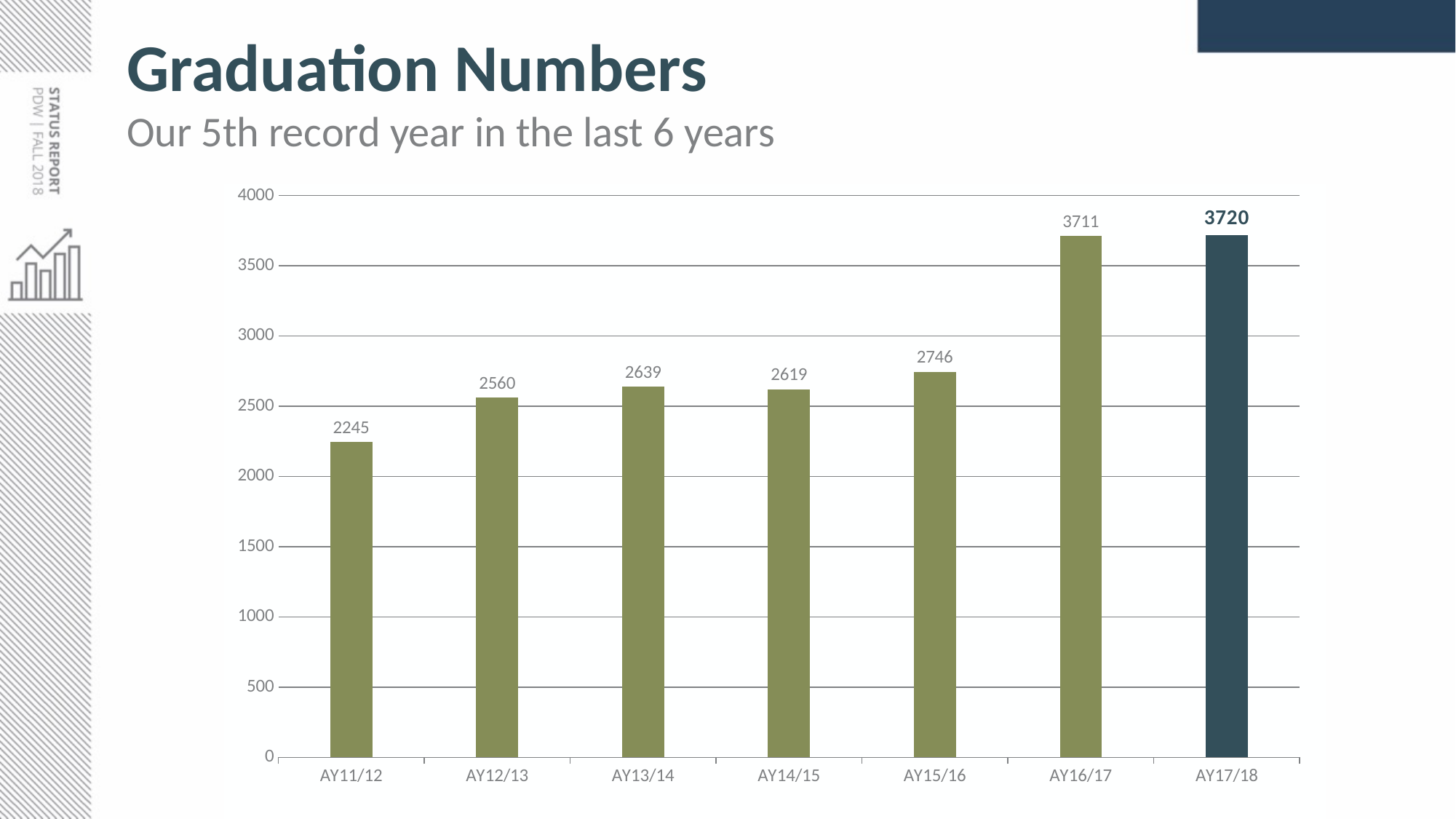
What is the graduation number for AY15/16? 2746 What is the graduation number for AY17/18? 3720 What kind of chart is shown on the slide? Bar chart What is the difference between the graduation numbers for AY16/17 and AY15/16? 965 What is the graduation number for AY11/12? 2245 Is the value for AY16/17 greater or less than 3500? greater Which is larger, the graduation number for AY13/14 or AY14/15? AY13/14 Which academic year has the highest graduation number? AY17/18 Which academic year has the lowest graduation number? AY11/12 What is the difference between the graduation numbers for AY12/13 and AY11/12? 315 Which bar is shown in a different colour from the others? AY17/18 How many academic years are shown on the chart? 7